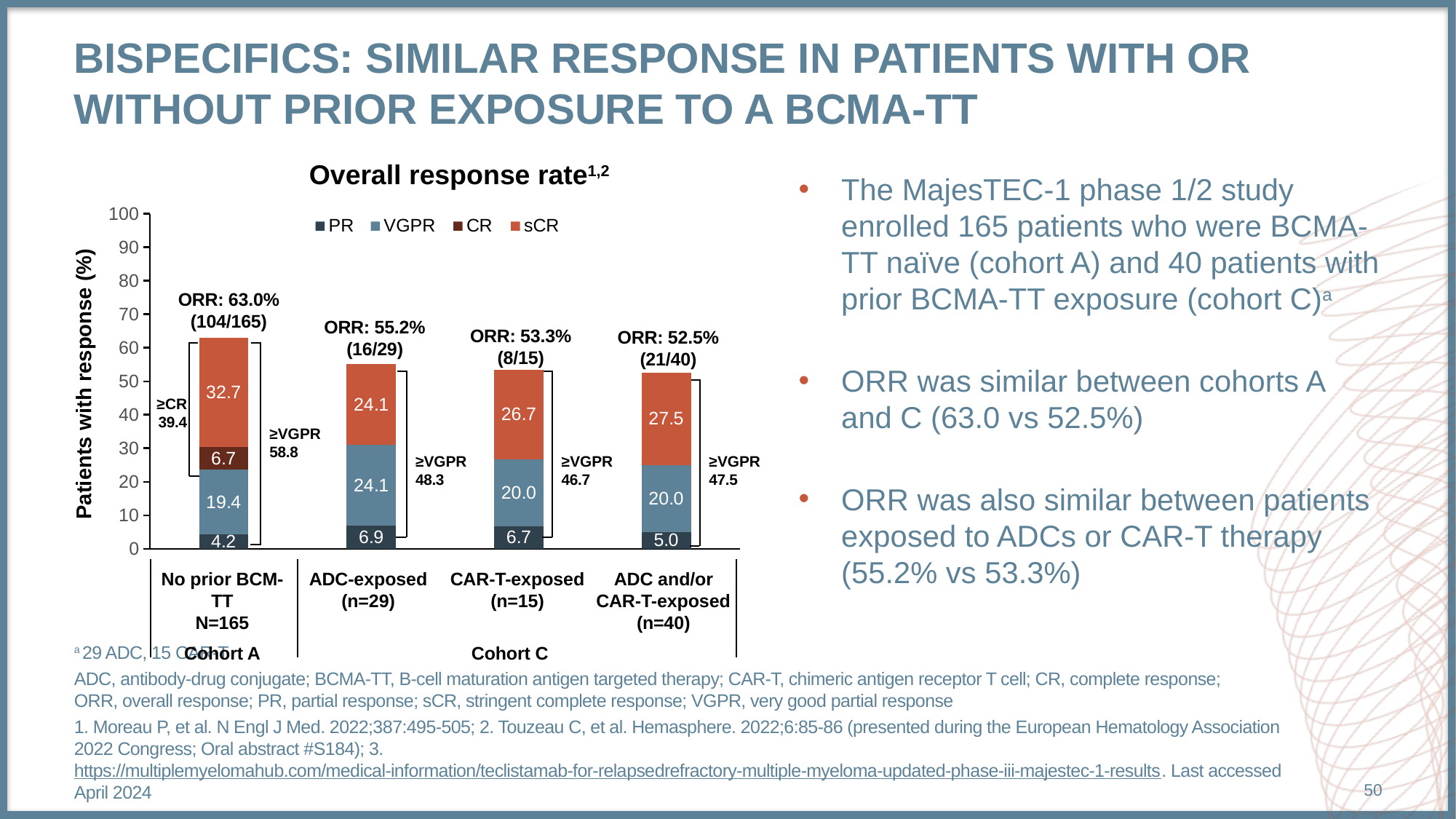
How many patient groups (bars) are shown in the chart? 4 Which group has the highest ORR? No prior BCMA-TT Which is larger, the sCR value for the CAR-T-exposed group or the sCR value for the ADC-exposed group? CAR-T-exposed What is the VGPR value for the ADC-exposed (n=29) group? 24.1 What is the title of the chart? Overall response rate What is the PR value for the CAR-T-exposed (n=15) group? 6.7 What is the difference between the ORR of the No prior BCMA-TT group and the ADC and/or CAR-T-exposed group? 10.5% What type of chart is shown on the slide? Stacked bar chart What is the ORR labelled for the ADC and/or CAR-T-exposed (n=40) group? 52.5% How many series does the chart legend list? 4 Which group has the lowest ORR? ADC and/or CAR-T-exposed (n=40) What is the sCR value for the No prior BCMA-TT group? 32.7